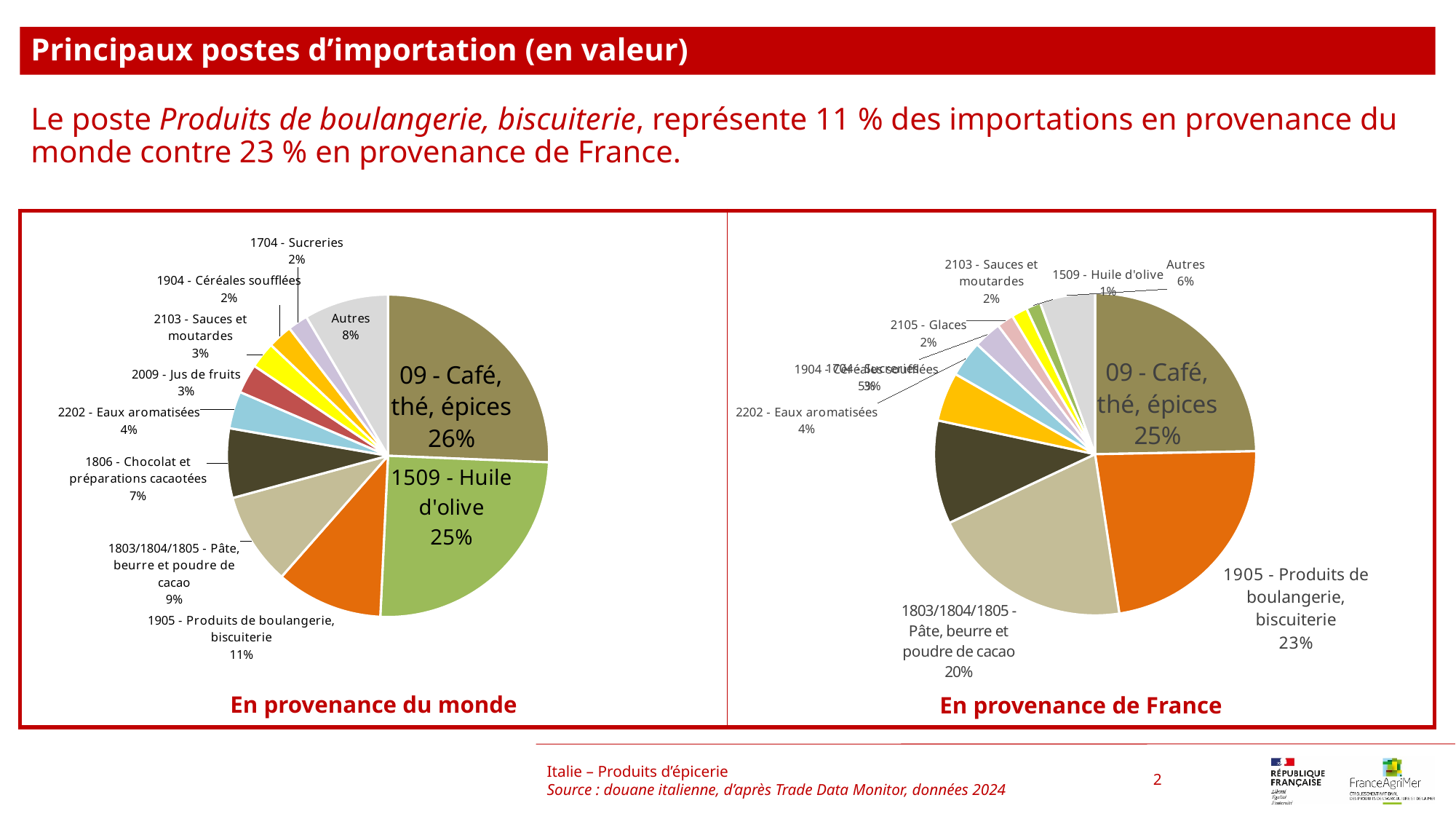
How many slices does the 'En provenance du monde' pie chart have? 11 In the 'En provenance de France' chart, what share does '1509 - Huile d'olive' represent? 1% In the 'En provenance du monde' chart, what share does '09 - Café, thé, épices' represent? 26% In the 'En provenance du monde' chart, what share does '1509 - Huile d'olive' represent? 25% In the 'En provenance de France' chart, what share does '1803/1804/1805 - Pâte, beurre et poudre de cacao' represent? 20% In the 'En provenance de France' chart, which is larger: '09 - Café, thé, épices' or '1905 - Produits de boulangerie, biscuiterie'? 09 - Café, thé, épices In the 'En provenance du monde' chart, which category has the largest share? 09 - Café, thé, épices In the 'En provenance de France' chart, what share does 'Autres' represent? 6% What kind of charts are shown on the slide? Pie charts In the 'En provenance de France' chart, what share does '1905 - Produits de boulangerie, biscuiterie' represent? 23% In the 'En provenance du monde' chart, what share does '1905 - Produits de boulangerie, biscuiterie' represent? 11% In the 'En provenance du monde' chart, what is the difference between the shares of '1803/1804/1805 - Pâte, beurre et poudre de cacao' and '1806 - Chocolat et préparations cacaotées'? 2 percentage points